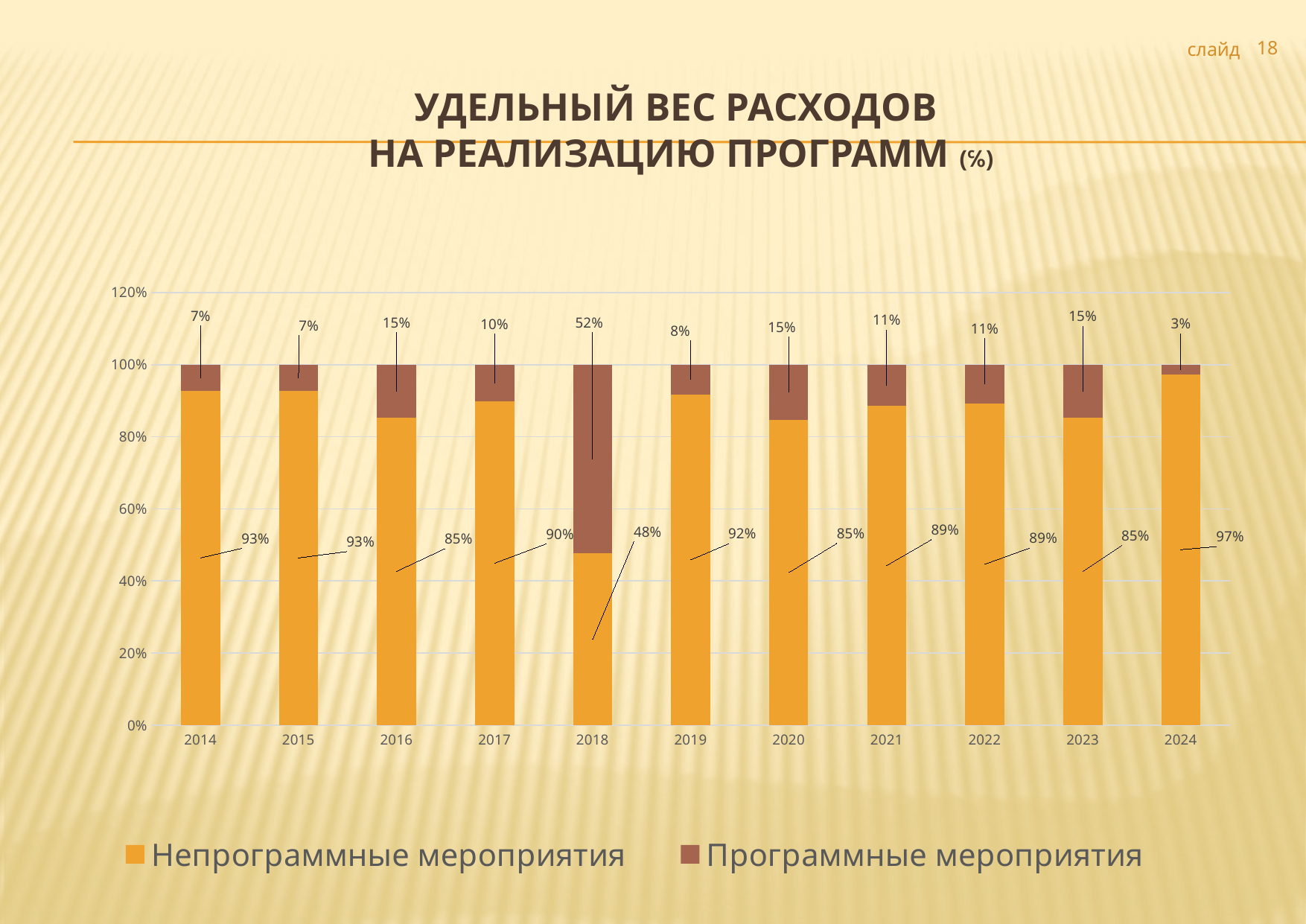
Which is larger: the Непрограммные мероприятия value for 2016 or for 2017? 2017 What is the total of the stacked bar for 2020? 100% In which year is the value for Программные мероприятия highest? 2018 What is the value for Программные мероприятия in 2024? 3% What is the value for Программные мероприятия in 2017? 10% What is the difference between the Программные мероприятия values for 2018 and 2019? 44% What is the value for Непрограммные мероприятия in 2018? 48% In which year is the value for Непрограммные мероприятия highest? 2024 How many series does the legend list? 2 How many years are shown on the x axis? 11 In which year is the value for Непрограммные мероприятия lowest? 2018 What type of chart is shown on the slide? stacked bar chart